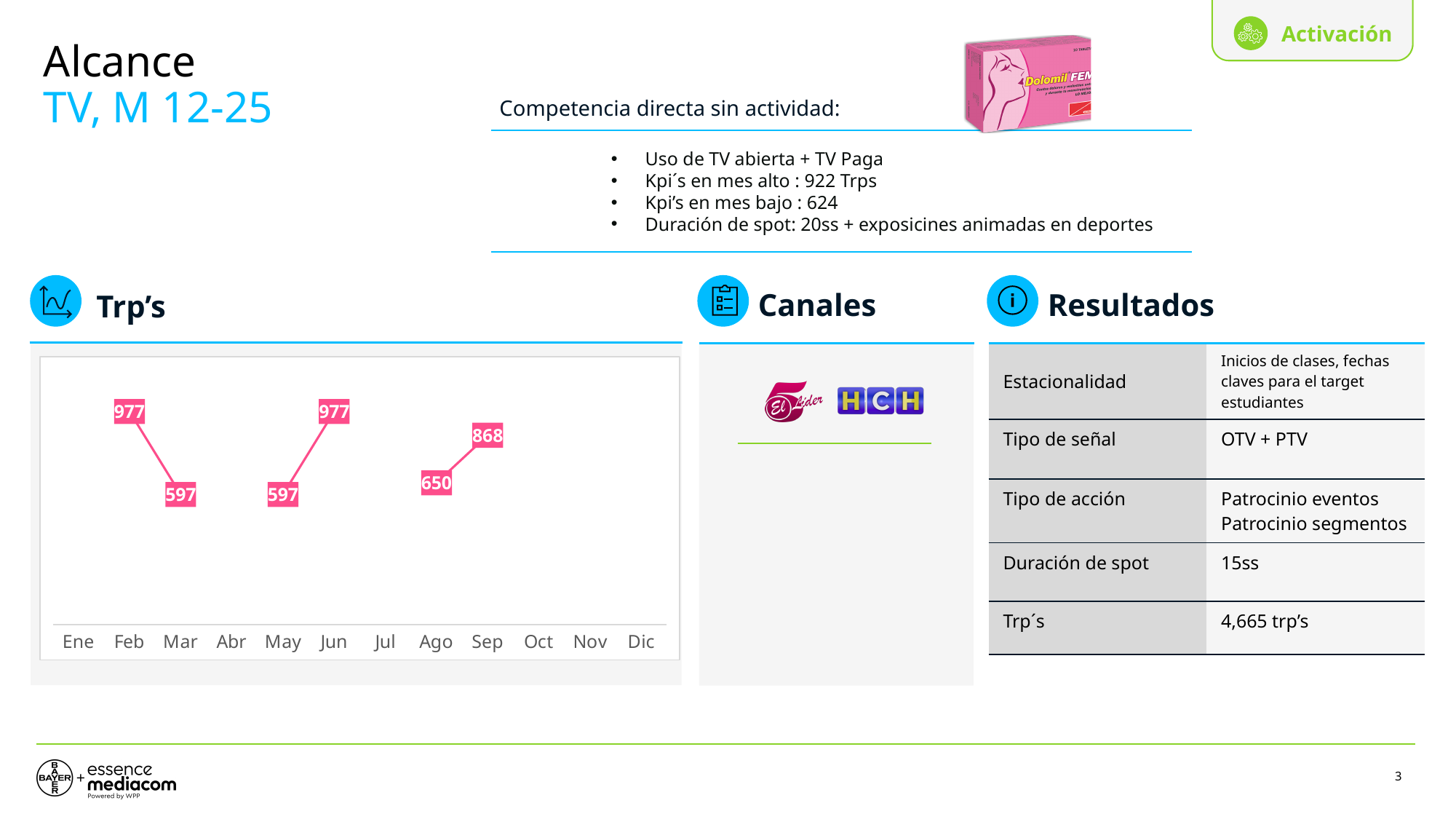
In the Trp's chart, what is the difference between the values for Feb and Mar? 380 In the Trp's chart, what is the difference between the values for Sep and Ago? 218 In the Trp's chart, what is the value for Jun? 977 In the Trp's chart, which month has the lowest labelled value? Mar and May (597) In the Trp's chart, what is the value for Sep? 868 What type of chart is shown in the Trp's section? line chart How many month categories are shown on the x axis of the Trp's chart? 12 In the Trp's chart, what is the value for Ago? 650 In the Trp's chart, which is larger, the value for Sep or the value for Ago? Sep In the Trp's chart, what is the value for Mar? 597 In the Trp's chart, does the value rise or fall from May to Jun? rise In the Trp's chart, what is the value for Feb? 977